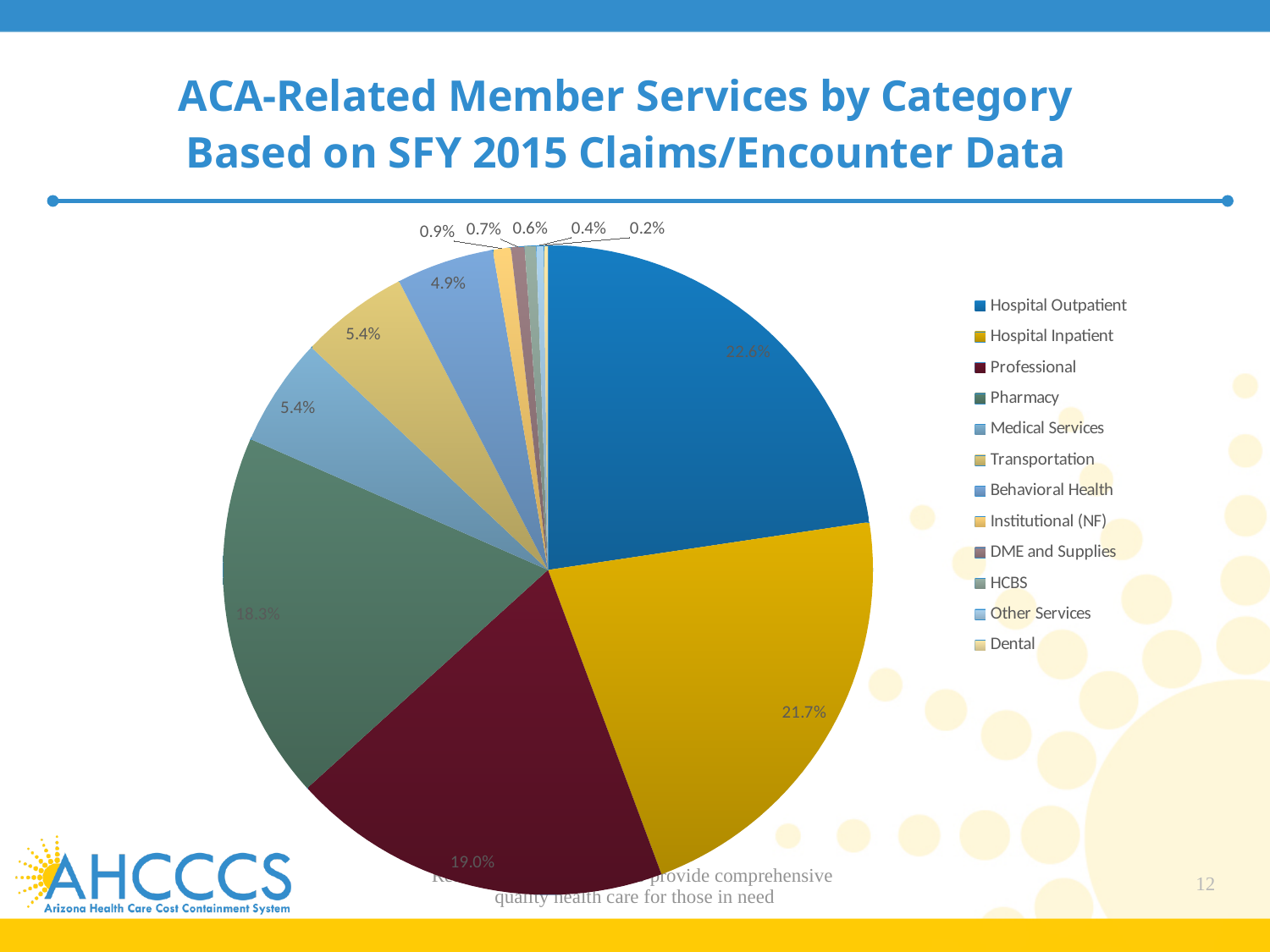
What share of ACA-related member services is Professional? 19.0% Which category has the largest share of the pie? Hospital Outpatient What share of ACA-related member services is Pharmacy? 18.3% What is the difference in percentage points between Hospital Outpatient and Hospital Inpatient? 0.9 What type of chart is shown on the slide? pie chart Which category has the smallest share of the pie? Dental How many categories does the legend list? 12 What share of ACA-related member services is Hospital Outpatient? 22.6% Which is larger, the Professional share or the Pharmacy share? Professional What share of ACA-related member services is Behavioral Health? 4.9% What is the title of the chart on the slide? ACA-Related Member Services by Category Based on SFY 2015 Claims/Encounter Data What share of ACA-related member services is Hospital Inpatient? 21.7%